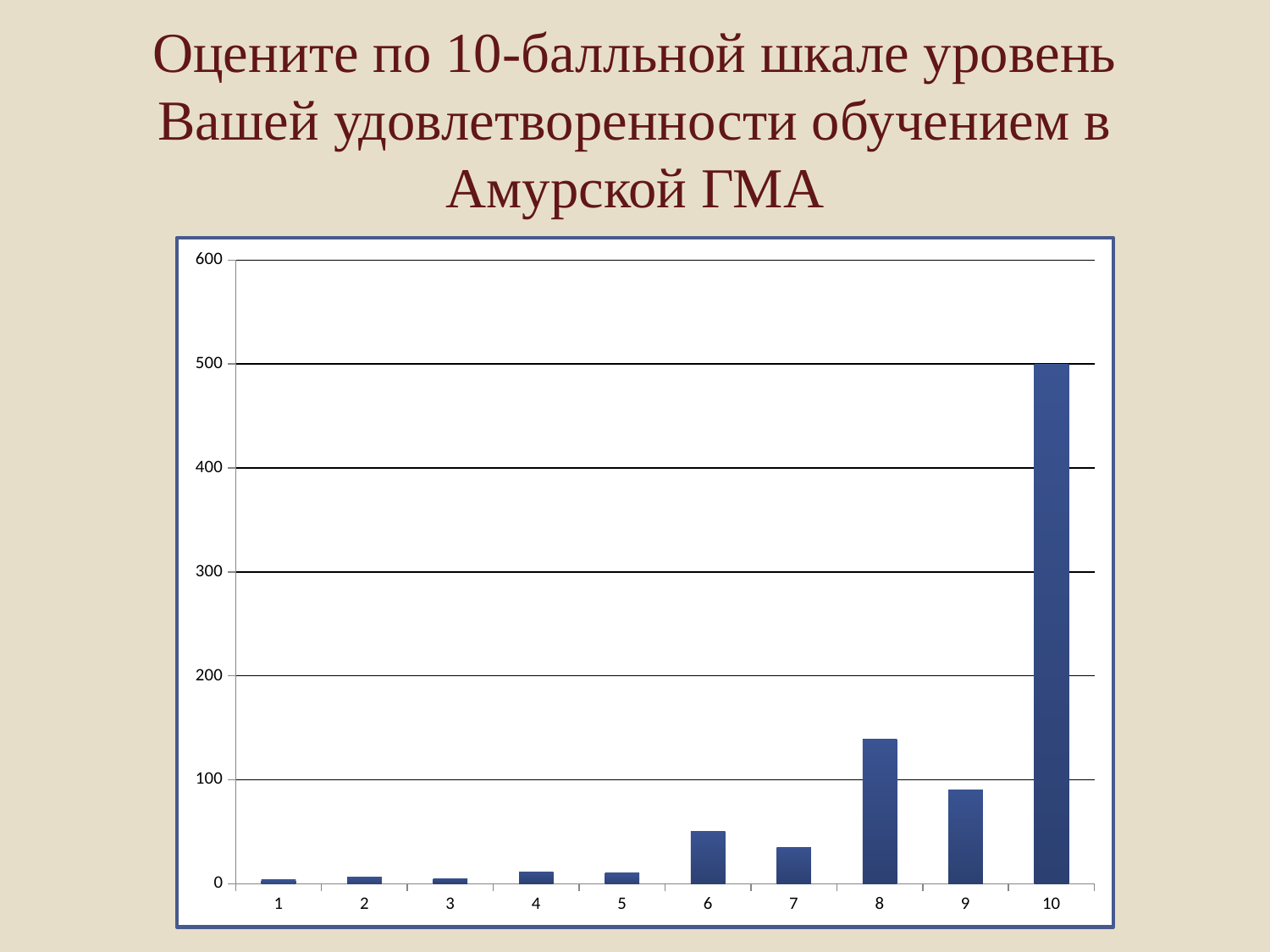
Which is larger, the value for category 8 or the value for category 9? 8 What is the highest value shown on the vertical axis of the chart? 600 Do the values generally rise or fall as the categories go from 1 to 10? rise Is the value for category 10 greater or less than 400? greater Is the value for category 6 greater or less than 100? less Is the value for category 9 greater or less than 100? less Which is larger, the value for category 6 or the value for category 7? 6 Which category has the highest bar in the chart? 10 How many categories are shown on the x axis of the chart? 10 What kind of chart is shown on the slide? bar chart What is the value for category 10 in the chart? 500